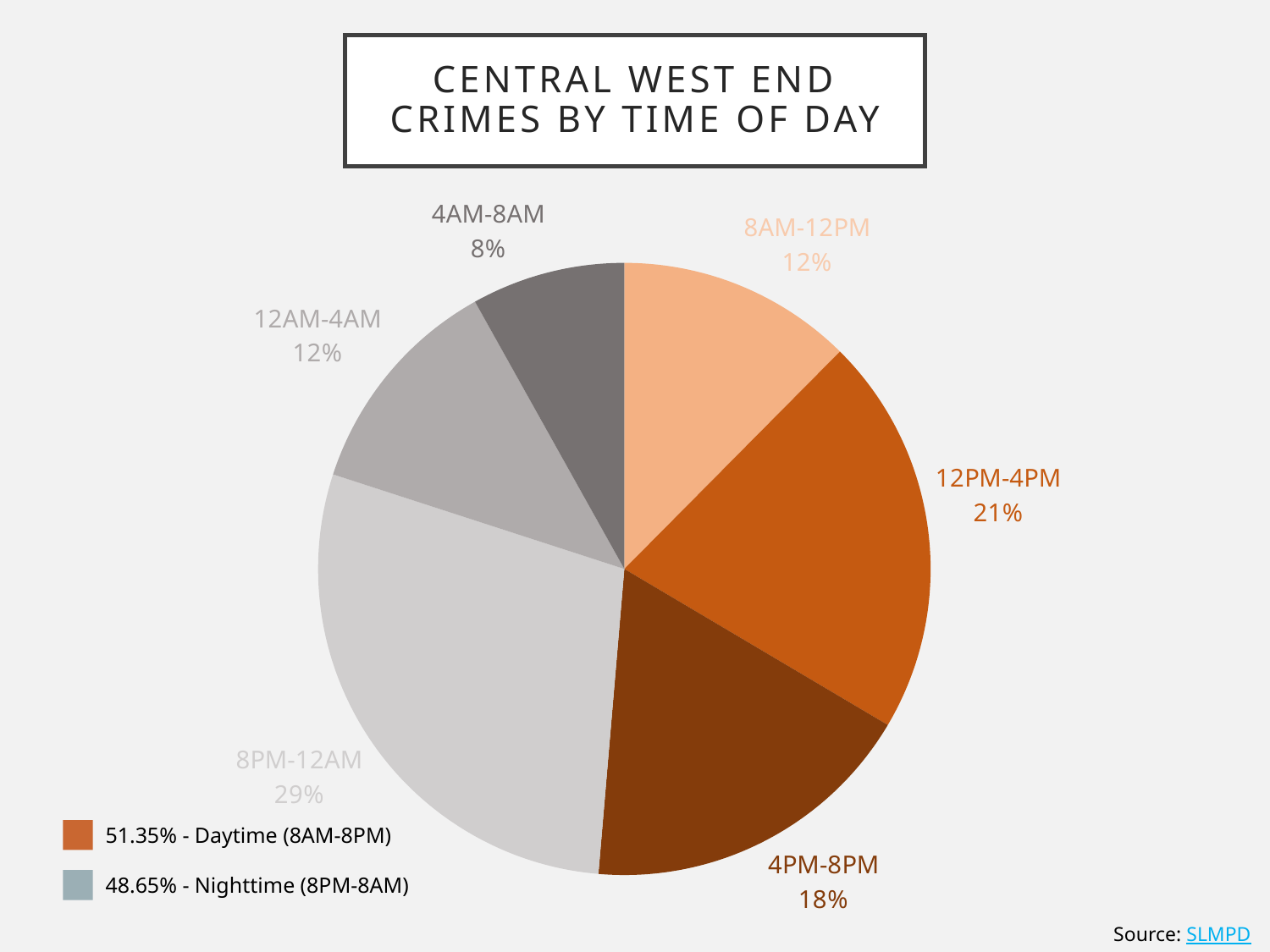
What percentage of crimes occur between 12PM and 4PM? 21% Which time period has the smallest share of crimes? 4AM-8AM What percentage of crimes occur between 8PM and 12AM? 29% How many time-of-day slices does the pie chart have? 6 What percentage of crimes occur between 4AM and 8AM? 8% What kind of chart is shown on the slide? pie chart What is the difference in percentage points between the 8PM-12AM slice and the 4PM-8PM slice? 11 According to the legend, what percentage of crimes occur during the daytime (8AM-8PM)? 51.35% Which time period has the largest share of crimes? 8PM-12AM What is the title of the chart? Central West End Crimes by Time of Day What is the combined share of the 12AM-4AM and 4AM-8AM slices? 20% Which slice is larger, 12PM-4PM or 4PM-8PM? 12PM-4PM